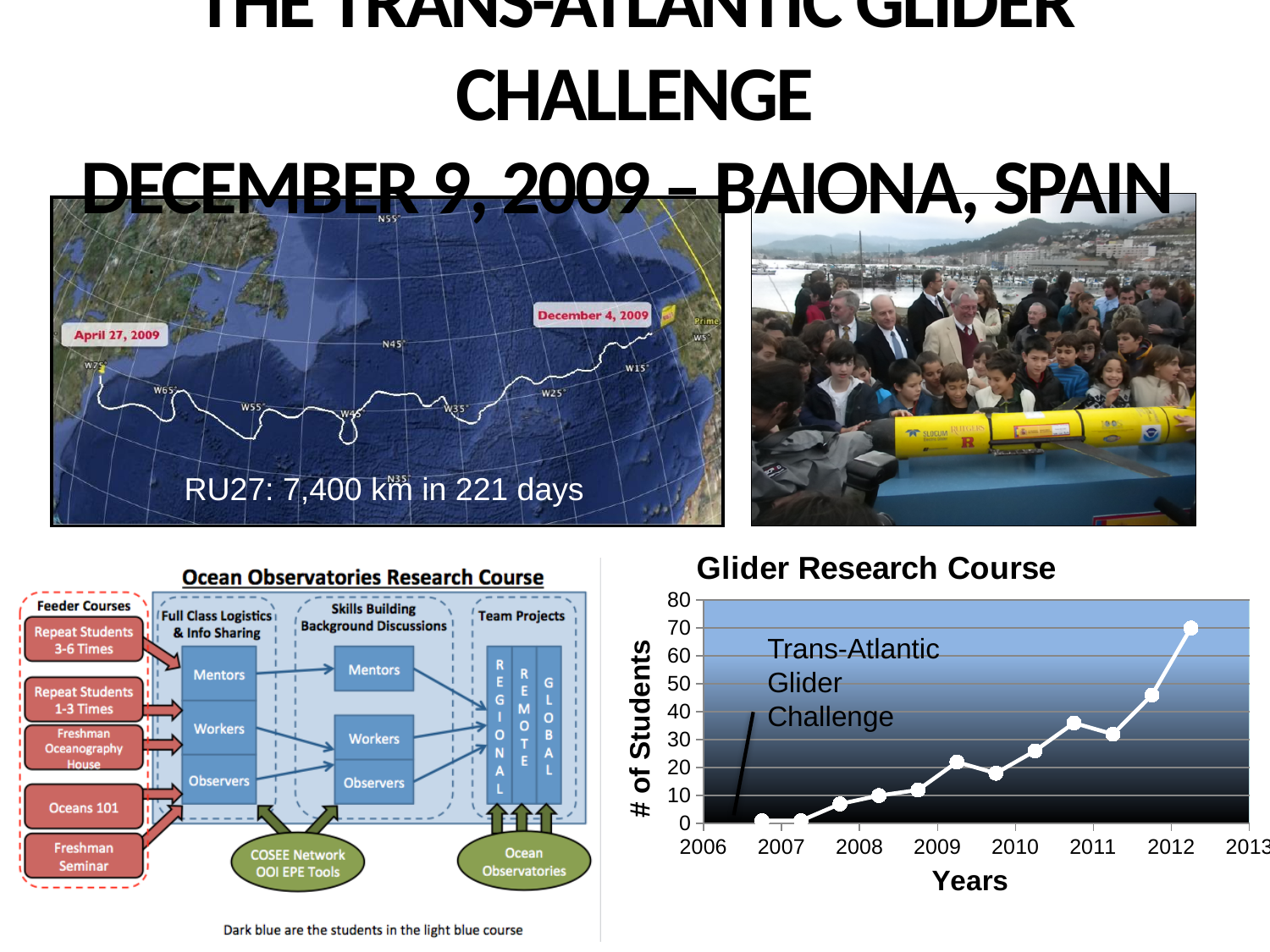
How many data points are plotted on the "Glider Research Course" chart? 12 What is the label of the y axis on the "Glider Research Course" chart? # of Students On the "Glider Research Course" chart, is the value of the point just before 2011 greater or less than 30? greater On the "Glider Research Course" chart, is the value of the last plotted point (around 2012) greater or less than 60? greater What is the highest value shown on the y axis of the "Glider Research Course" chart? 80 On the "Glider Research Course" chart, is the value of the first plotted point (around 2007) greater or less than 10? less On the "Glider Research Course" chart, which is larger: the value of the point around 2012 or the value of the point around 2008? the point around 2012 On the "Glider Research Course" chart, is the highest point at the beginning or the end of the series? the end On the "Glider Research Course" chart, do the values generally rise or fall from 2006 to 2013? rise What kind of chart is the "Glider Research Course" chart? line chart What is the title of the chart on the lower right of the slide? Glider Research Course